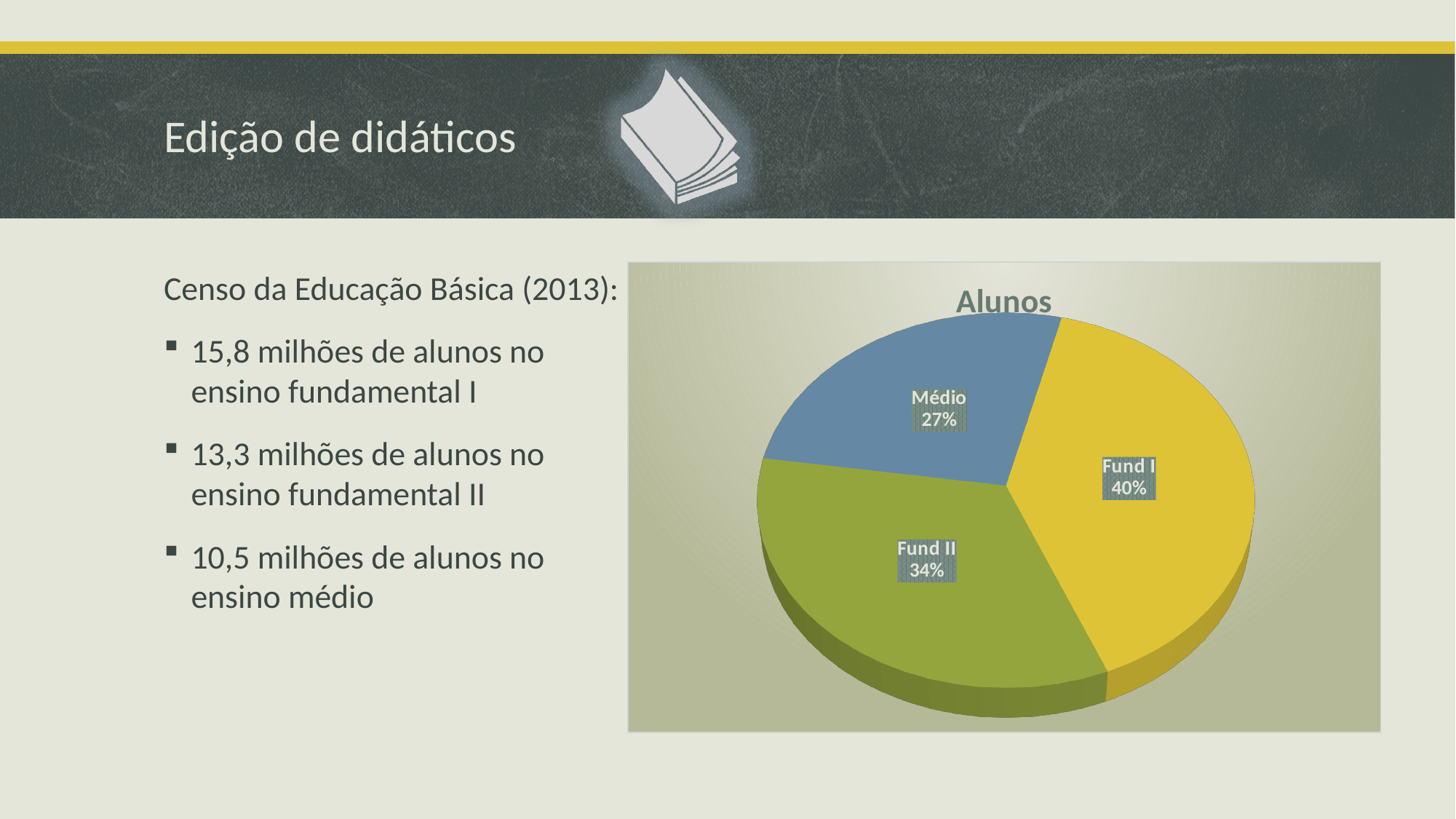
What is the difference in percentage points between the Fund II and Médio slices? 7 What share of the pie does Fund I represent? 40% Which is larger, the Fund II slice or the Médio slice? Fund II What is the difference in percentage points between the Fund I and Médio slices? 13 What share of the pie does Fund II represent? 34% How many slices does the pie chart have? 3 What colour is the Fund I slice? yellow What is the title of the chart? Alunos What kind of chart is shown on the slide? pie chart Which slice of the pie is the smallest? Médio What share of the pie does Médio represent? 27% Which slice of the pie is the largest? Fund I